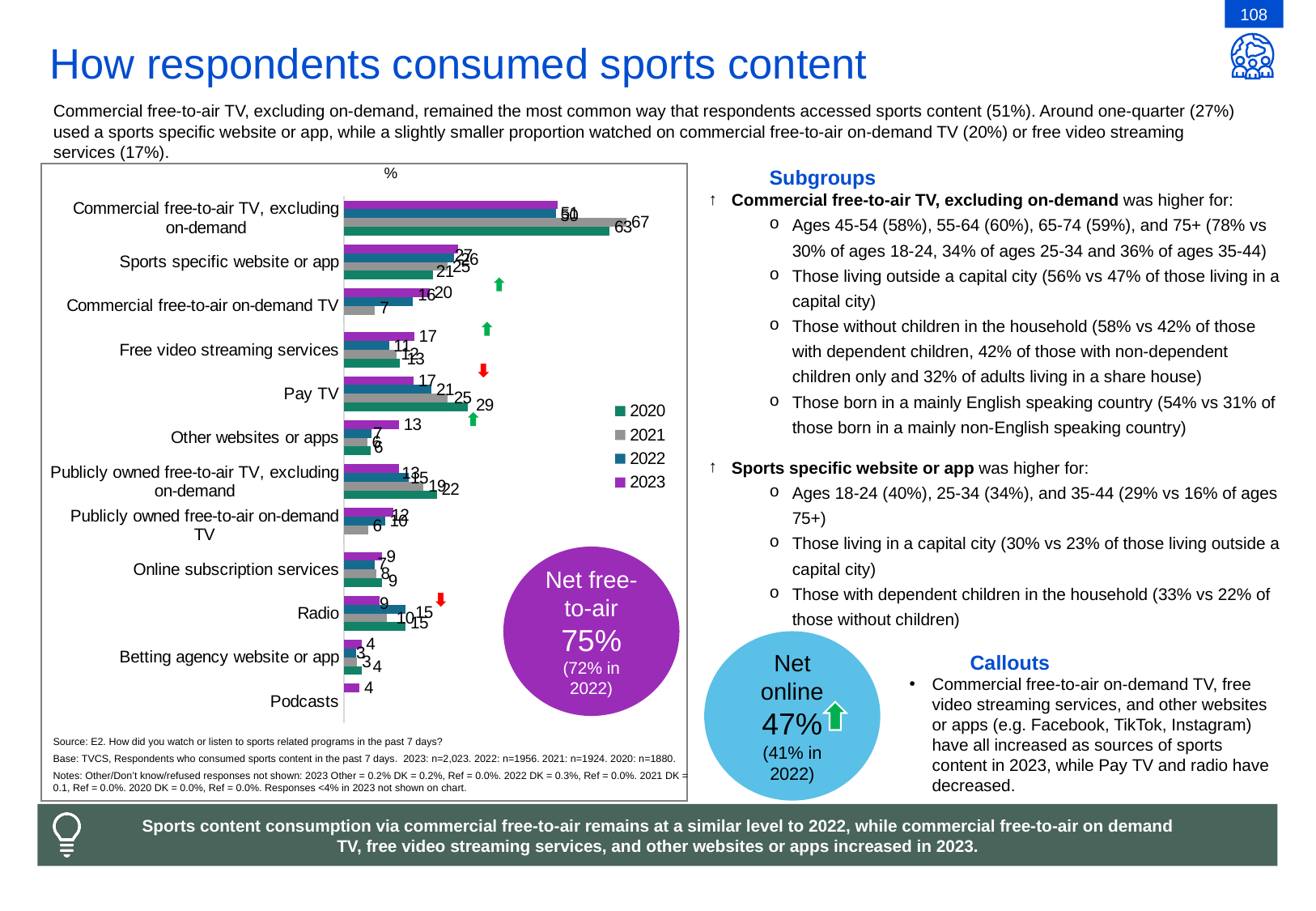
In 2023, which was larger: Pay TV or Other websites or apps? Pay TV What type of chart is shown on the slide? Bar chart What was the 2023 value for Free video streaming services? 17 What was the 2020 value for Commercial free-to-air TV, excluding on-demand? 63 Did the value for Pay TV rise or fall from 2020 to 2023? Fall What was the 2020 value for Pay TV? 29 How many series does the chart legend list? 4 How many categories (ways of consuming sports content) are shown on the chart? 12 Which category had the highest value in 2023? Commercial free-to-air TV, excluding on-demand What is the Net free-to-air figure shown in the purple circle on the chart? 75% By how many percentage points did Pay TV fall from 2020 (29) to 2023 (17)? 12 What was the 2023 value for Commercial free-to-air on-demand TV? 20